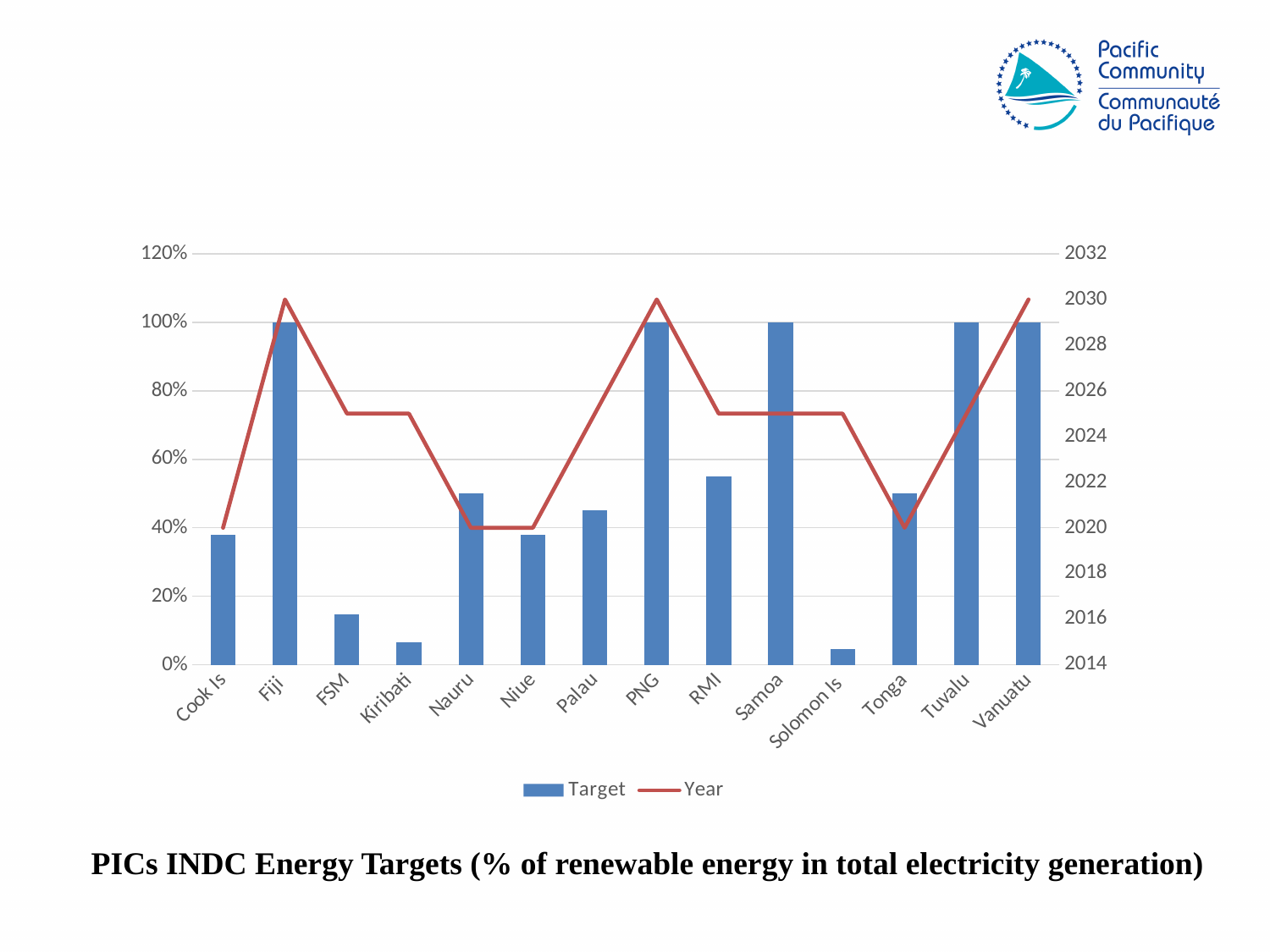
What is the Target value for Tuvalu? 100% What Year does the line show for Nauru? 2020 Which country has the lowest Target value? Solomon Is Which has the larger Target value, Nauru or Niue? Nauru What Year does the line show for Fiji? 2030 How many countries are shown on the x axis of the chart? 14 How many series does the legend list? 2 What is the Target value for Fiji? 100% What are the two entries in the chart's legend? Target and Year What kind of chart is shown on the slide? bar chart with a line Is the Target value for RMI greater or less than 40%? greater Is the Target value for Cook Is greater or less than 40%? less